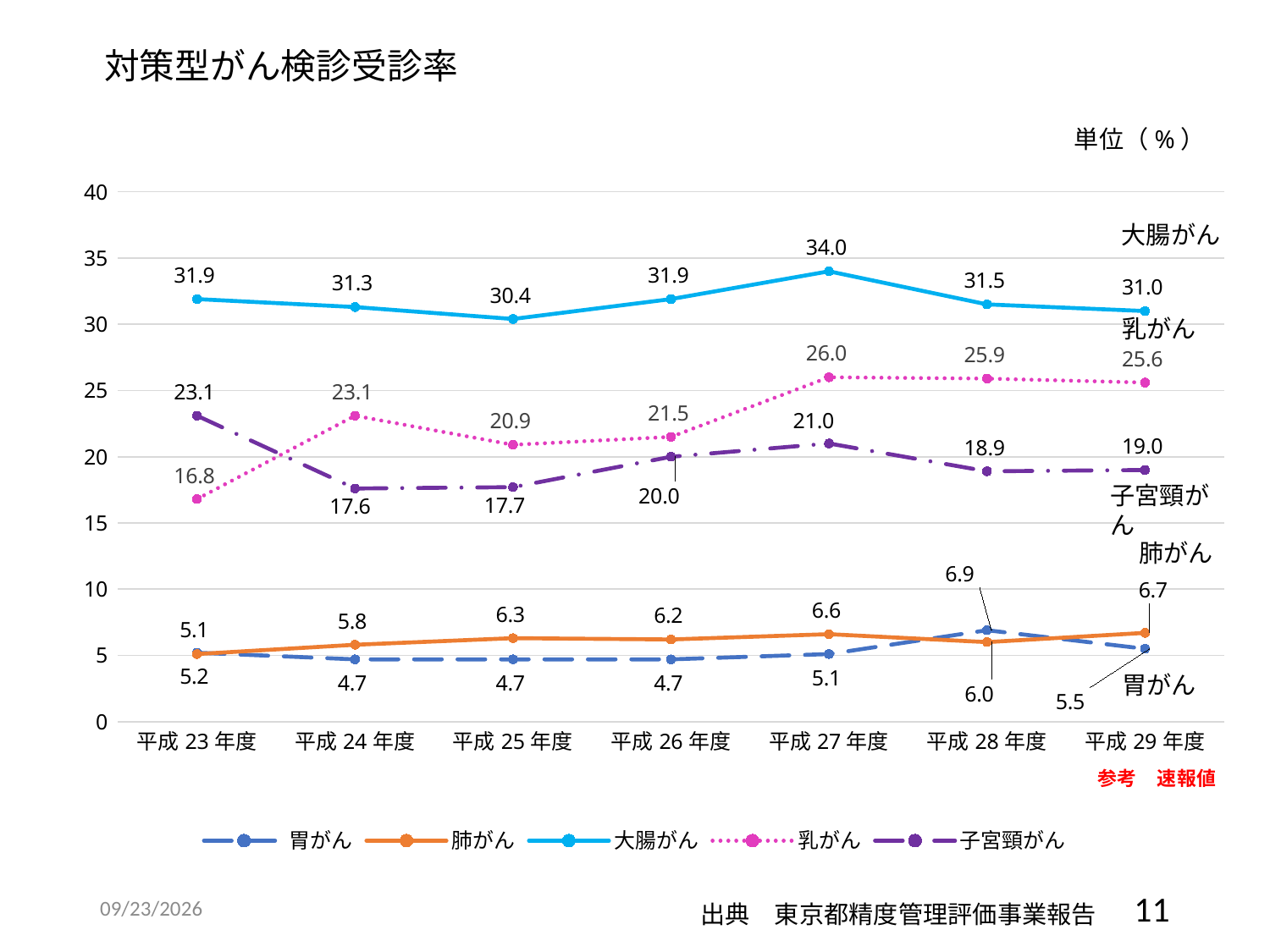
What is the value for 大腸がん in 平成27年度? 34.0 What is the difference between the 乳がん value in 平成27年度 and in 平成23年度? 9.2 How many series does the legend list? 5 In which fiscal year is the value for 大腸がん highest? 平成27年度 What unit is indicated for the values in the chart? % What is the value for 胃がん in 平成28年度? 6.9 What is the value for 乳がん in 平成23年度? 16.8 In which fiscal year is the value for 乳がん lowest? 平成23年度 What is the value for 子宮頸がん in 平成29年度? 19.0 Which is larger in 平成24年度, the value for 乳がん or for 子宮頸がん? 乳がん How many fiscal years are plotted on the x axis? 7 What type of chart is shown on the slide? line chart